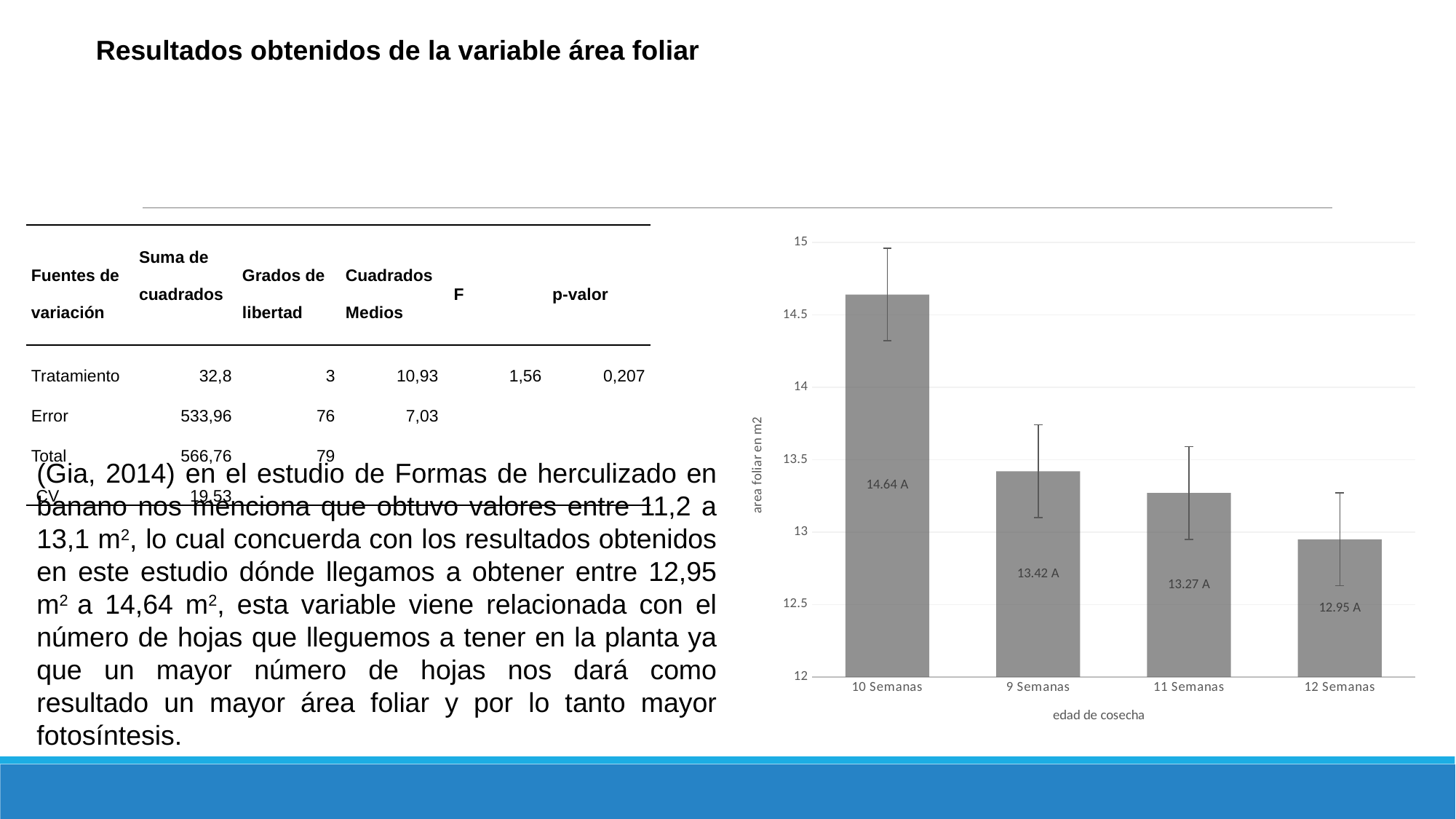
Which harvest age has the highest leaf area? 10 Semanas What kind of chart is shown on the slide? bar chart What is the value shown for 10 Semanas? 14.64 A Which is larger, the value for 9 Semanas or the value for 12 Semanas? 9 Semanas How many harvest-age categories are plotted in the chart? 4 What is the value shown for 11 Semanas? 13.27 A Is the value for 10 Semanas greater or less than 14.5? greater What is the difference between the values for 10 Semanas and 12 Semanas? 1.69 What is the value shown for 12 Semanas? 12.95 A What is the value shown for 9 Semanas? 13.42 A Which harvest age has the lowest leaf area? 12 Semanas Do the bar values rise or fall from left to right along the x axis? fall